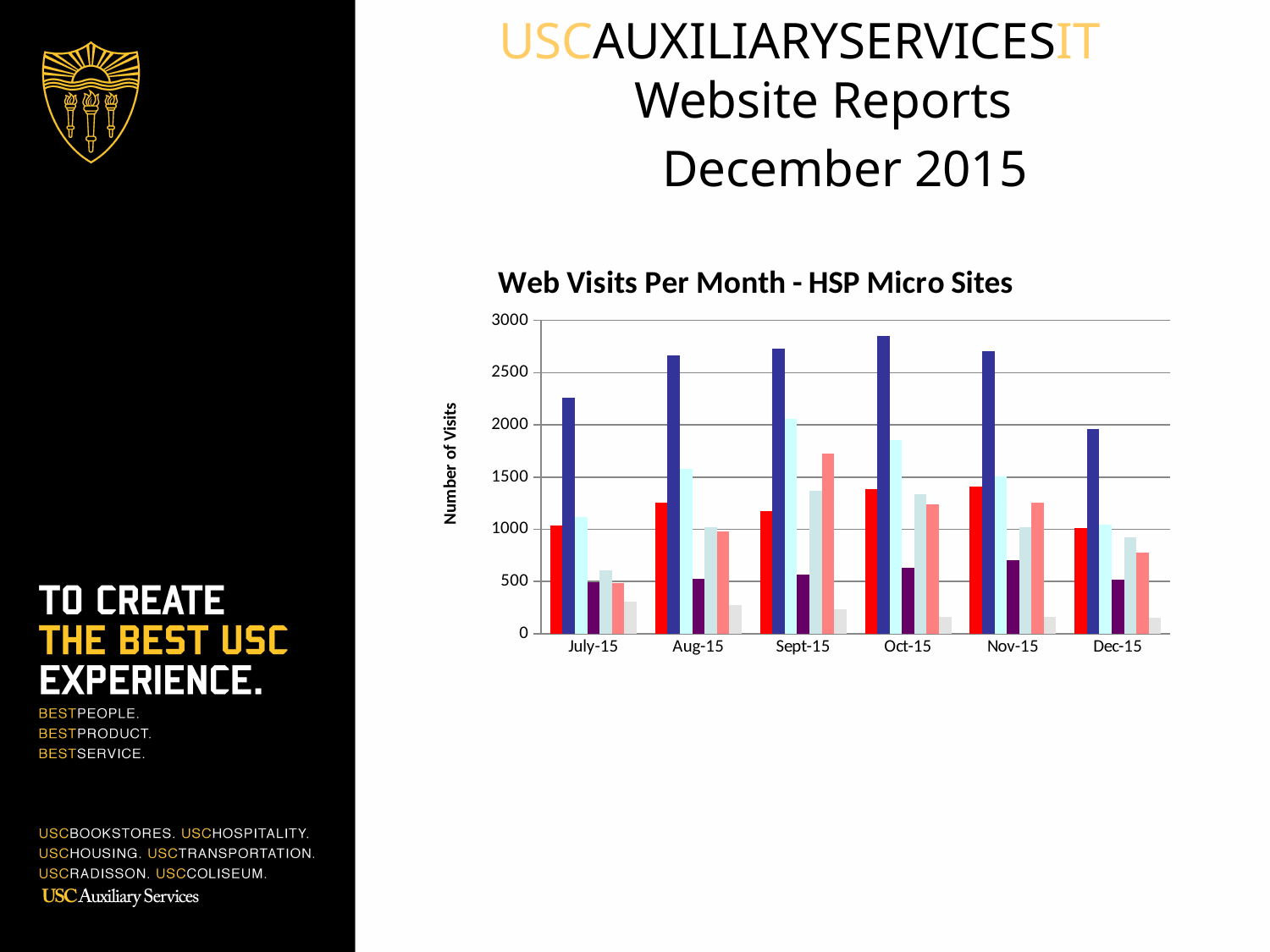
What kind of chart is shown on the slide? bar chart How many months are shown along the x axis of the chart? 6 Is the pink bar for Sept-15 greater or less than 1500? greater In which month is the dark blue bar the tallest? Oct-15 Is the dark blue bar for Oct-15 greater or less than 2500? greater Does the dark blue bar rise or fall from July-15 to Oct-15? rise What is the label on the vertical axis of the chart? Number of Visits Is the purple bar for Oct-15 greater or less than 1000? less What is the title of the chart? Web Visits Per Month - HSP Micro Sites Which is larger, the dark blue bar for July-15 or the dark blue bar for Dec-15? July-15 In which month is the dark blue bar the shortest? Dec-15